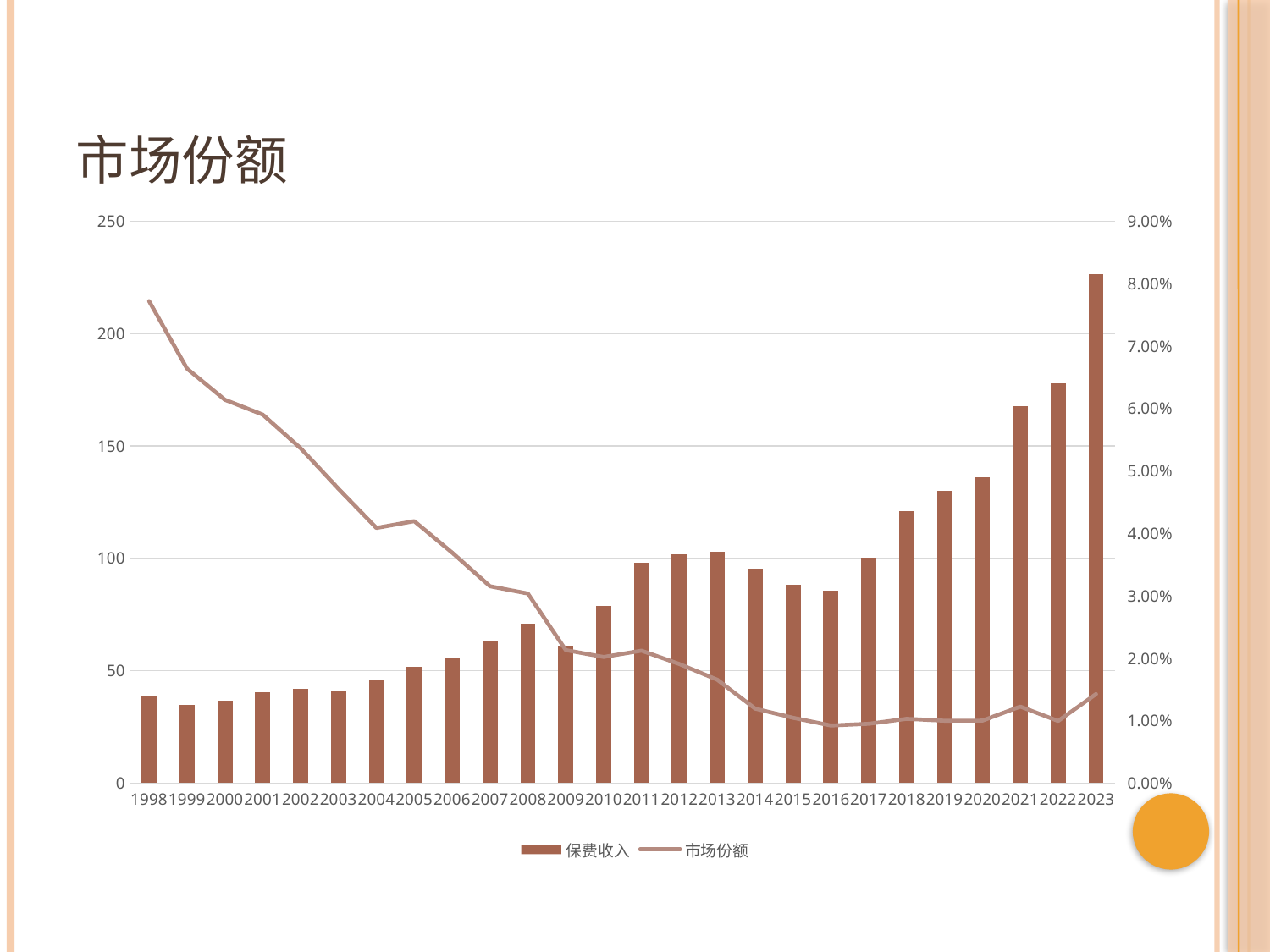
In which year is the 市场份额 line at its highest? 1998 Which year has the highest 保费收入 bar? 2023 What kind of chart is shown on the slide? A combination bar and line chart Is the 市场份额 value for 2016 greater or less than 2.00%? less Is the 市场份额 value for 1998 greater or less than 7.00%? greater How many years are shown on the x axis? 26 Is the 保费收入 value for 1998 greater or less than 50? less Does the 市场份额 line generally rise or fall from 1998 to 2016? fall Which year has the larger 保费收入 bar, 2008 or 2009? 2008 How many series does the legend list? 2